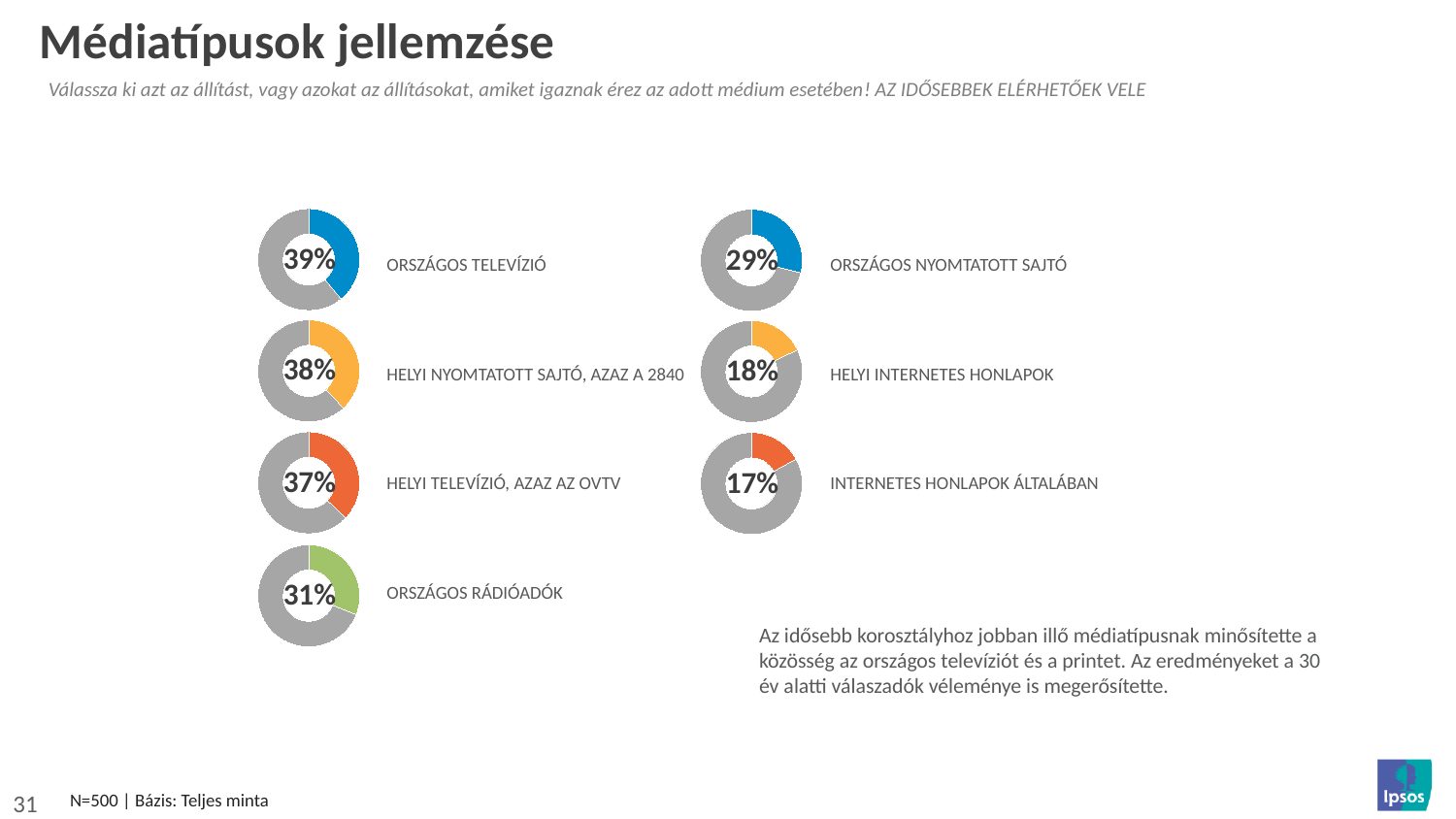
What percentage is shown in the donut chart labelled ORSZÁGOS RÁDIÓADÓK? 31% What percentage is shown in the donut chart labelled HELYI INTERNETES HONLAPOK? 18% Which media type has the highest percentage among the donut charts on the slide? ORSZÁGOS TELEVÍZIÓ How many donut charts are shown on the slide? 7 Which media type has the lowest percentage among the donut charts on the slide? INTERNETES HONLAPOK ÁLTALÁBAN Which has a higher percentage: HELYI TELEVÍZIÓ, AZAZ AZ OVTV or HELYI INTERNETES HONLAPOK? HELYI TELEVÍZIÓ, AZAZ AZ OVTV What percentage is shown in the donut chart labelled ORSZÁGOS NYOMTATOTT SAJTÓ? 29% What colour is the highlighted segment in the donut chart for ORSZÁGOS RÁDIÓADÓK? Green What percentage is shown in the donut chart labelled ORSZÁGOS TELEVÍZIÓ? 39% What is the difference between the percentage for ORSZÁGOS TELEVÍZIÓ and the percentage for ORSZÁGOS NYOMTATOTT SAJTÓ? 10% What is the difference between the percentage for HELYI NYOMTATOTT SAJTÓ, AZAZ A 2840 and the percentage for HELYI INTERNETES HONLAPOK? 20% What kind of chart is used to show the percentage for each media type on the slide? Donut (pie) chart